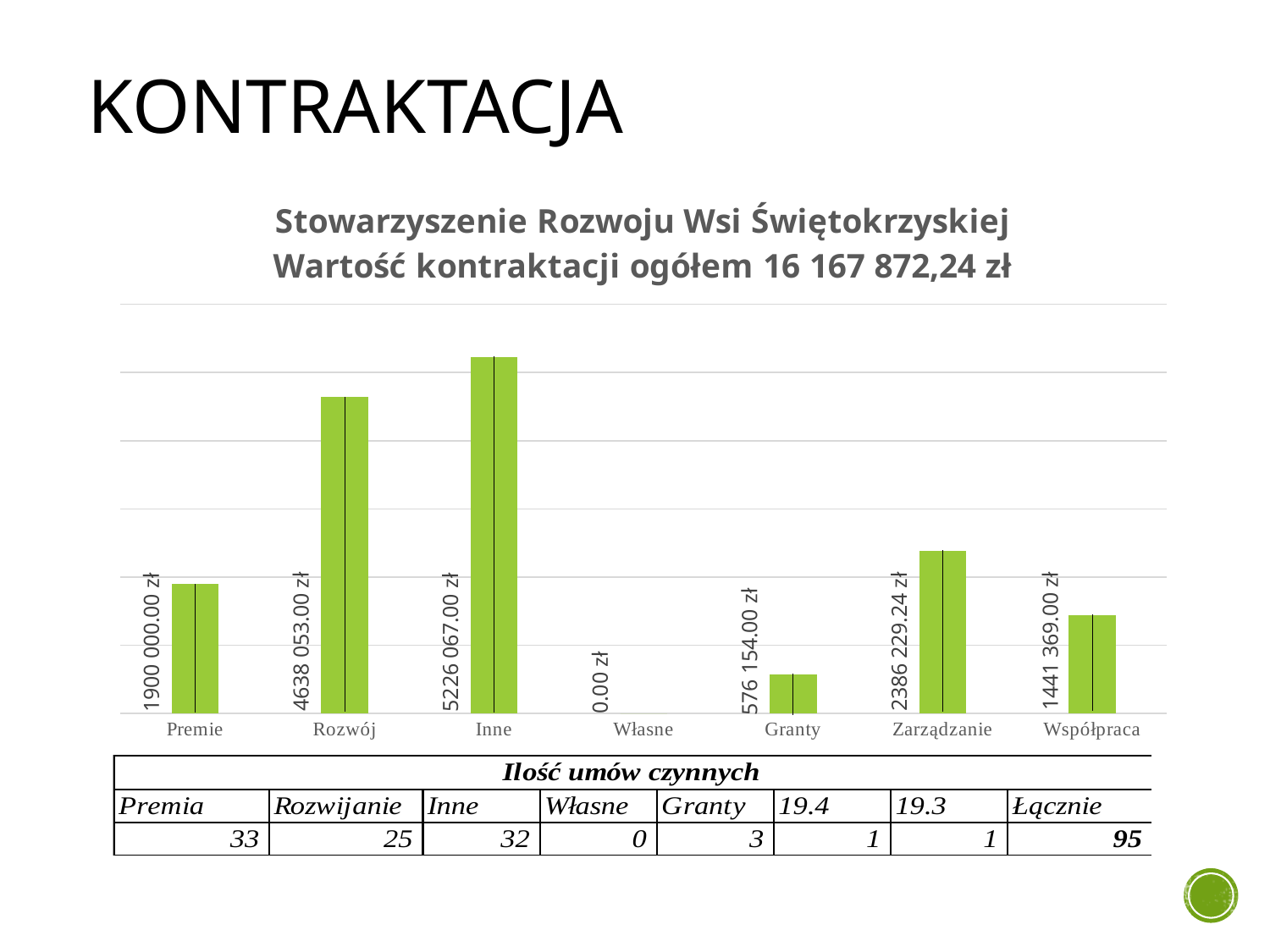
What is the value for Granty? 576 154.00 zł What is the difference between the values for Inne and Rozwój? 588 014.00 zł Which category has the highest value? Inne What kind of chart is shown on the slide? Bar chart What is the value for Rozwój? 4638 053.00 zł What is the value for Zarządzanie? 2386 229.24 zł How many categories are shown in the chart? 7 Which category has the lowest value? Własne What is the value for Współpraca? 1441 369.00 zł What is the value for Premie? 1900 000.00 zł Which is larger, the value for Zarządzanie or the value for Premie? Zarządzanie What is the difference between the values for Premie and Współpraca? 458 631.00 zł